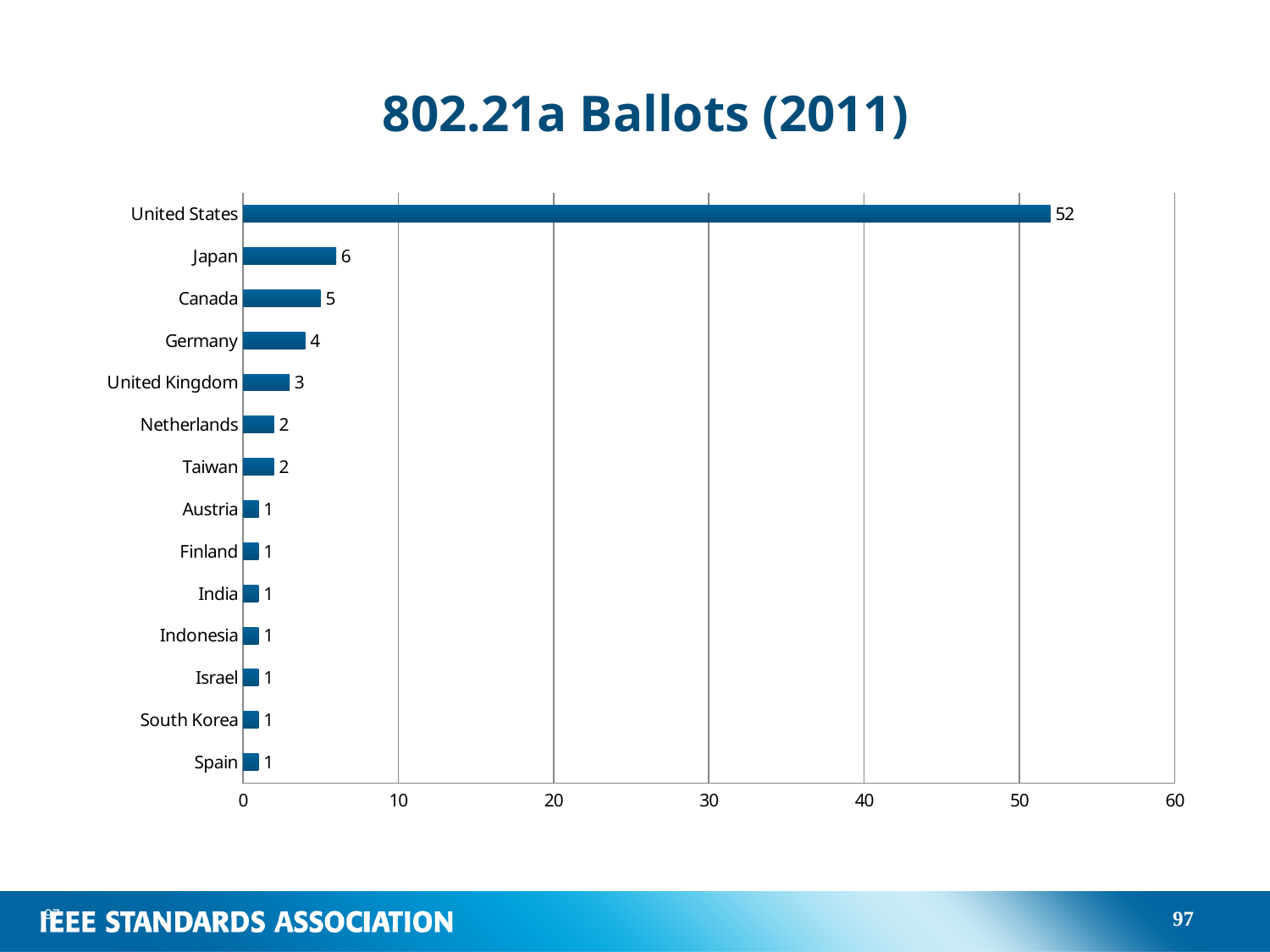
Which is larger, the value for Germany or the value for Netherlands? Germany What is the value for Japan? 6 What is the value for the United Kingdom? 3 What is the difference between the values for the United States and Japan? 46 What is the value for the United States? 52 What kind of chart is shown on the slide? bar chart What is the difference between the values for Canada and Germany? 1 Is the value for the United States greater or less than 50? greater Which country has the highest value? United States How many countries have a value of 1? 7 What is the title of the chart? 802.21a Ballots (2011) How many countries are shown in the chart? 14